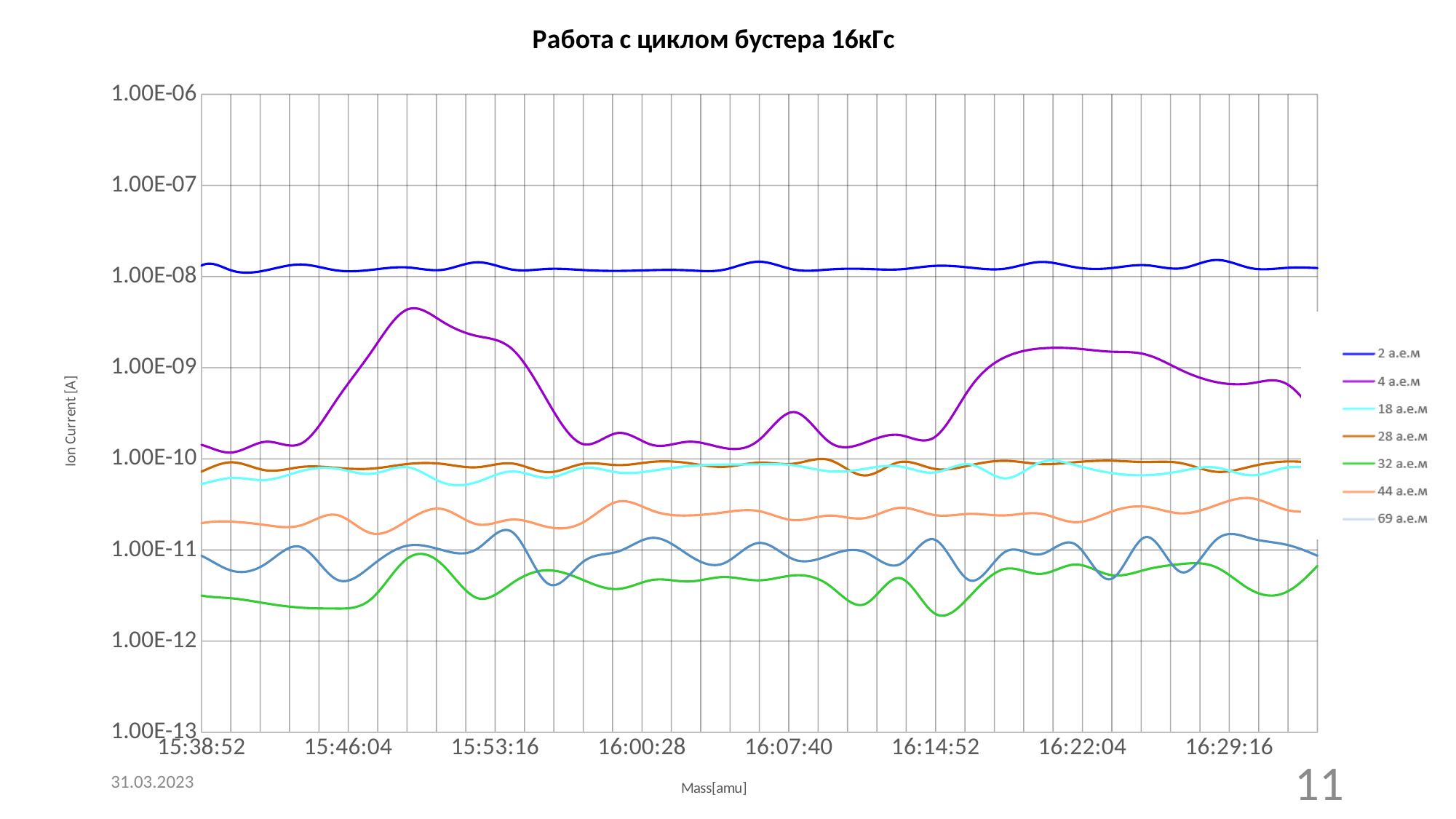
Is the peak value of 4 а.е.м near 15:49 greater or less than 1.00E-09? greater Is the value for 4 а.е.м at 16:00:28 greater or less than 1.00E-09? less What kind of chart is shown on the slide? line chart Which series has larger values, 2 а.е.м or 4 а.е.м? 2 а.е.м Which series has larger values, 44 а.е.м or 32 а.е.м? 44 а.е.м Is the value for 32 а.е.м at 15:38:52 greater or less than 1.00E-11? less How many series does the legend list? 7 What is the title of the chart? Работа с циклом бустера 16кГс Which series has the highest values across the whole chart? 2 а.е.м What is the label of the vertical axis? Ion Current [A] Which series reaches the lowest value on the chart? 32 а.е.м